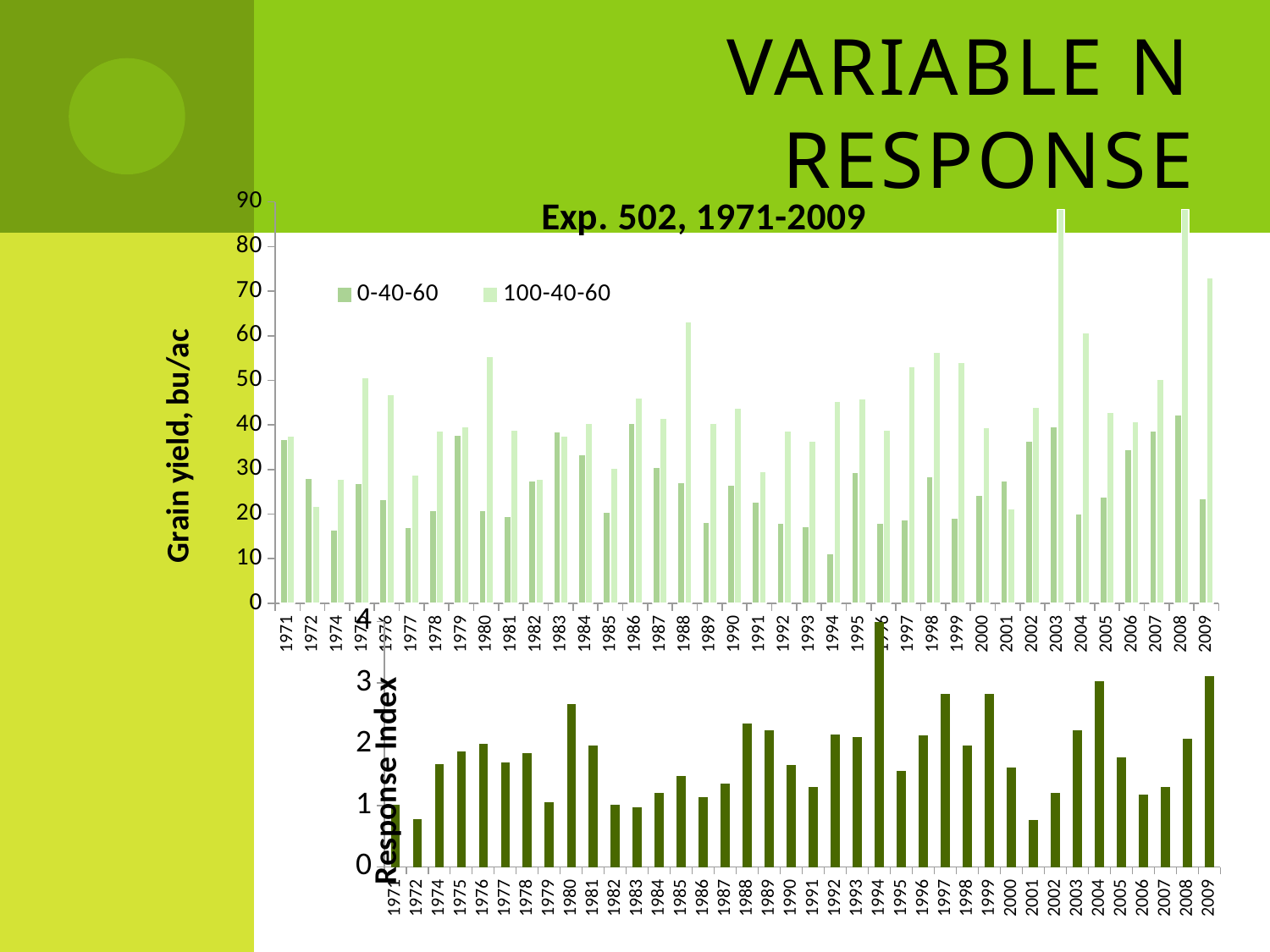
In the top chart "Exp. 502, 1971-2009", which year has the lowest 0-40-60 value? 1994 In the bottom chart (Response Index), which year has the highest value? 1994 What is the y-axis label of the top chart "Exp. 502, 1971-2009"? Grain yield, bu/ac How many series does the legend of the top chart "Exp. 502, 1971-2009" list? 2 In the bottom chart (Response Index), is the value for 1972 greater or less than 1? less In the top chart "Exp. 502, 1971-2009", is the 0-40-60 value for 1994 greater or less than 20? less In the top chart "Exp. 502, 1971-2009", is the 100-40-60 value for 1988 greater or less than 50? greater What kind of chart is the top chart titled "Exp. 502, 1971-2009"? bar chart In the top chart "Exp. 502, 1971-2009", what are the two legend entries? 0-40-60 and 100-40-60 In the top chart "Exp. 502, 1971-2009", which series has the larger value in 1980, 0-40-60 or 100-40-60? 100-40-60 In the bottom chart (Response Index), which year has the larger value, 1994 or 1979? 1994 In the top chart "Exp. 502, 1971-2009", which year has the larger 0-40-60 value, 1986 or 1994? 1986